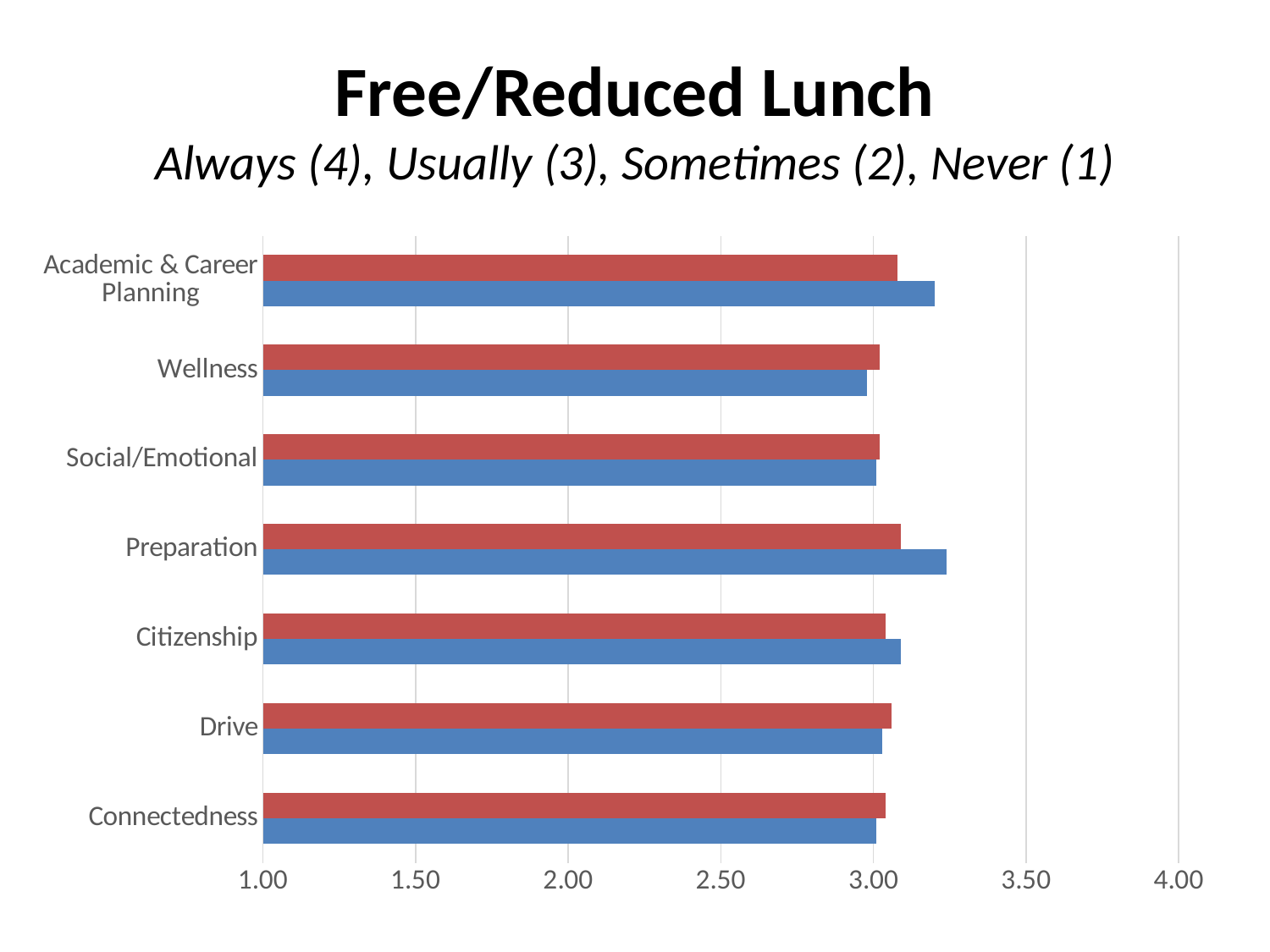
Is the blue bar for Preparation greater or less than 3.50? less How many bars are shown for each category? 2 For Preparation, which bar is longer, the red one or the blue one? blue What is the highest value shown on the horizontal axis? 4.00 Is the blue bar for Academic & Career Planning greater or less than 3.00? greater Is the blue bar for Citizenship greater or less than 3.00? greater What is the title of the chart? Free/Reduced Lunch How many categories are shown on the chart? 7 Which category has the longest blue bar? Preparation For Academic & Career Planning, which bar is longer, the red one or the blue one? blue What kind of chart is shown on the slide? bar chart